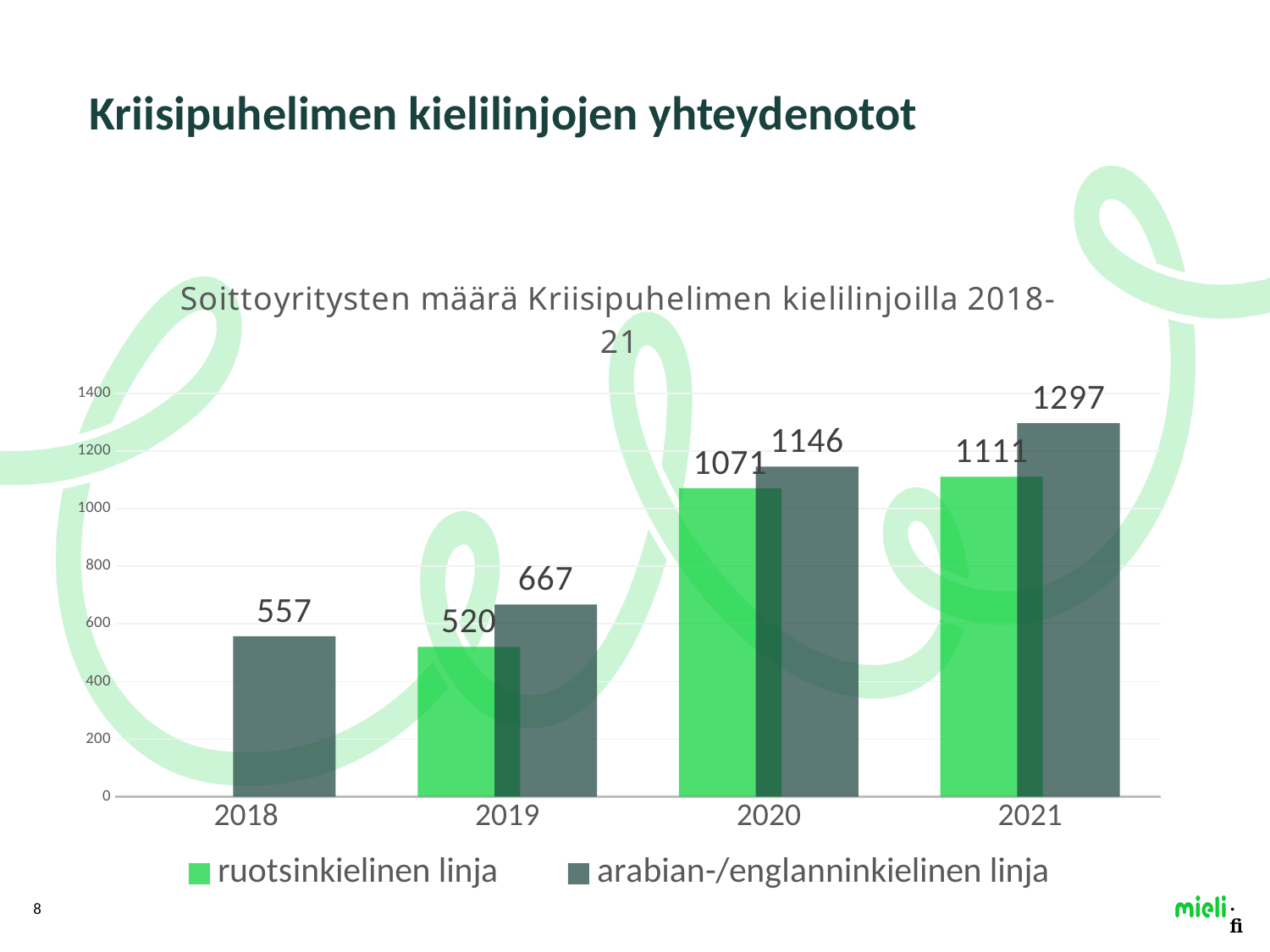
What is the difference between the arabian-/englanninkielinen linja and ruotsinkielinen linja values in 2020? 75 Which is larger in 2019: the ruotsinkielinen linja value or the arabian-/englanninkielinen linja value? arabian-/englanninkielinen linja What is the value for the ruotsinkielinen linja series in 2019? 520 Which year has the highest value for the ruotsinkielinen linja series? 2021 What is the value for the arabian-/englanninkielinen linja series in 2018? 557 How many years are shown on the x axis? 4 How many series does the legend list? 2 What is the value for the arabian-/englanninkielinen linja series in 2021? 1297 Is the value for ruotsinkielinen linja in 2021 greater or less than 1000? greater Do the values for the arabian-/englanninkielinen linja series rise or fall from 2018 to 2021? rise What kind of chart is shown on the slide? bar chart Which year has the lowest value for the arabian-/englanninkielinen linja series? 2018